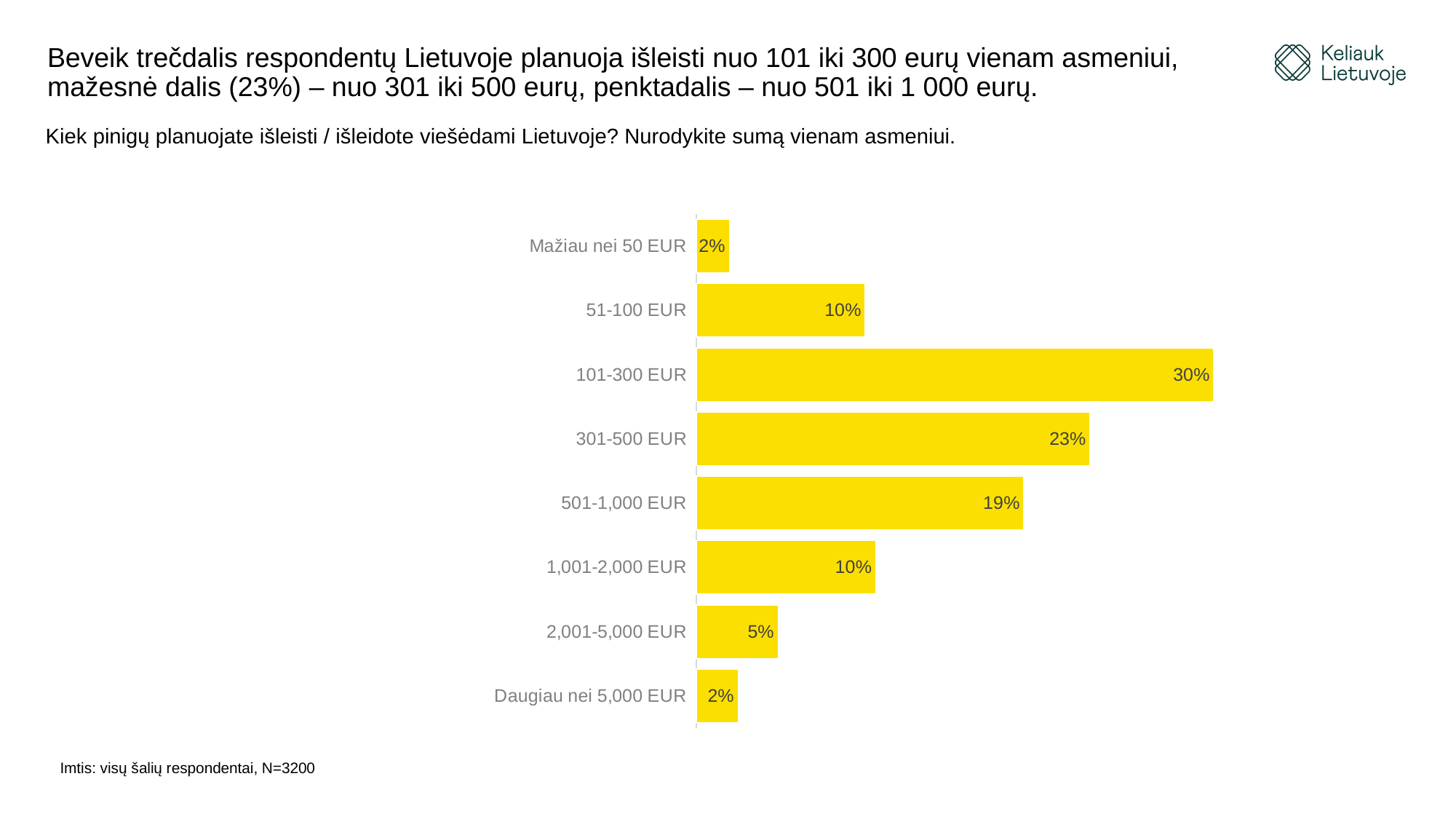
What value is shown for the 'Mažiau nei 50 EUR' category? 2% How many spending categories are shown in the chart? 8 Which spending category has the highest share of respondents? 101-300 EUR What is the difference in percentage points between the 101-300 EUR and 301-500 EUR categories? 7 What percentage is shown for 2,001-5,000 EUR? 5% What is the difference in percentage points between the 301-500 EUR and 1,001-2,000 EUR categories? 13 What colour are the bars in the chart? Yellow What percentage of respondents plan to spend 101-300 EUR per person? 30% What is the value shown for the 501-1,000 EUR category? 19% Which is larger, the value for 51-100 EUR or the value for 501-1,000 EUR? 501-1,000 EUR What is the sample size (N) stated on the slide? N=3200 What type of chart is used on this slide? Bar chart